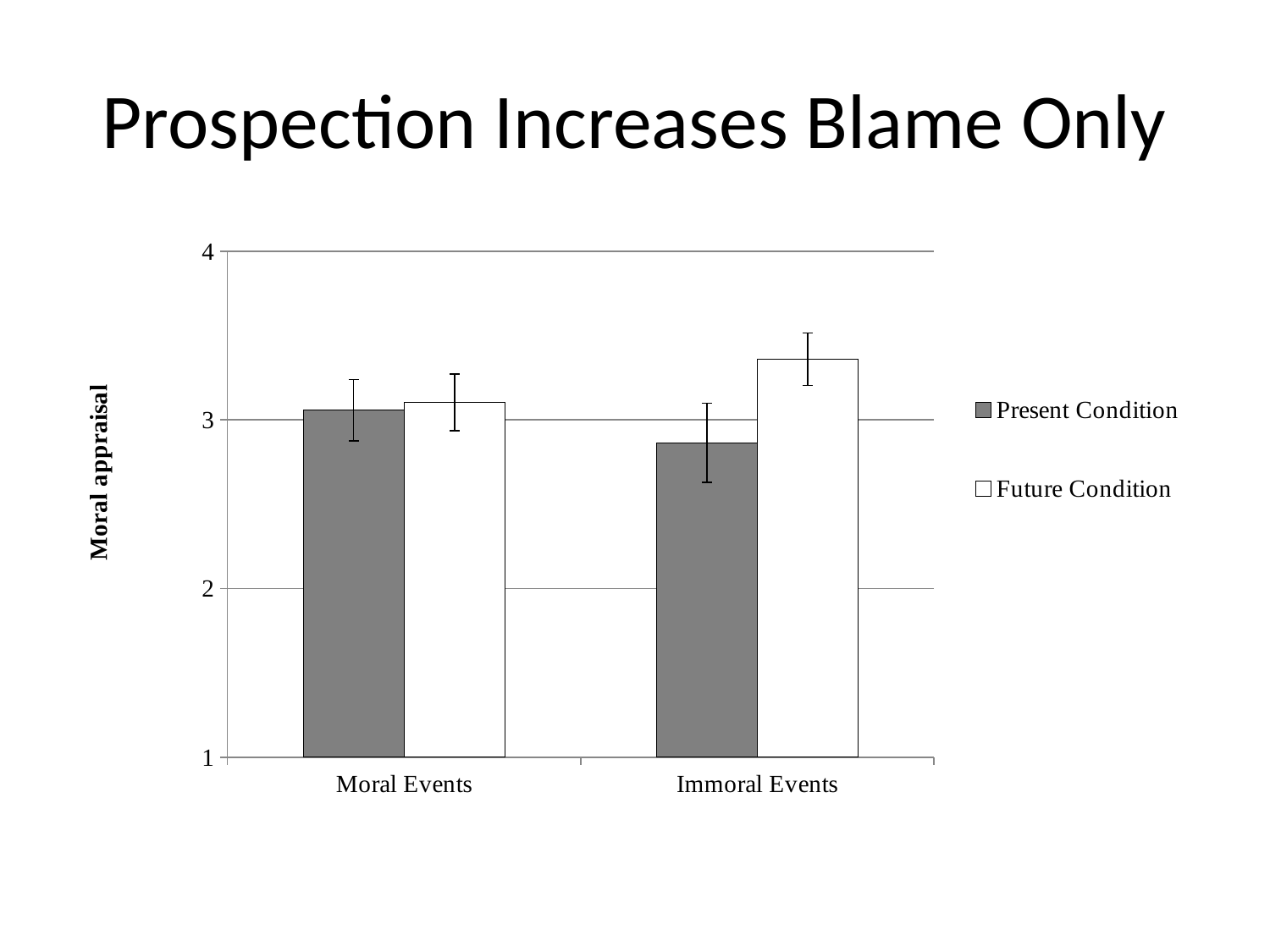
Which bar is the lowest in the chart? Present Condition for Immoral Events How many categories are shown on the x axis? 2 Does the Present Condition value rise or fall from Moral Events to Immoral Events? fall For Immoral Events, which is larger: the Present Condition or the Future Condition? Future Condition Is the value for the Future Condition in Moral Events greater or less than 2? greater What is the label on the vertical axis? Moral appraisal Which bar is the highest in the chart? Future Condition for Immoral Events What kind of chart is shown on the slide? Bar chart Is the value for the Present Condition in Immoral Events greater or less than 3? less How many series does the legend list? 2 Is the value for the Future Condition in Immoral Events greater or less than 3? greater Does the Future Condition value rise or fall from Moral Events to Immoral Events? rise